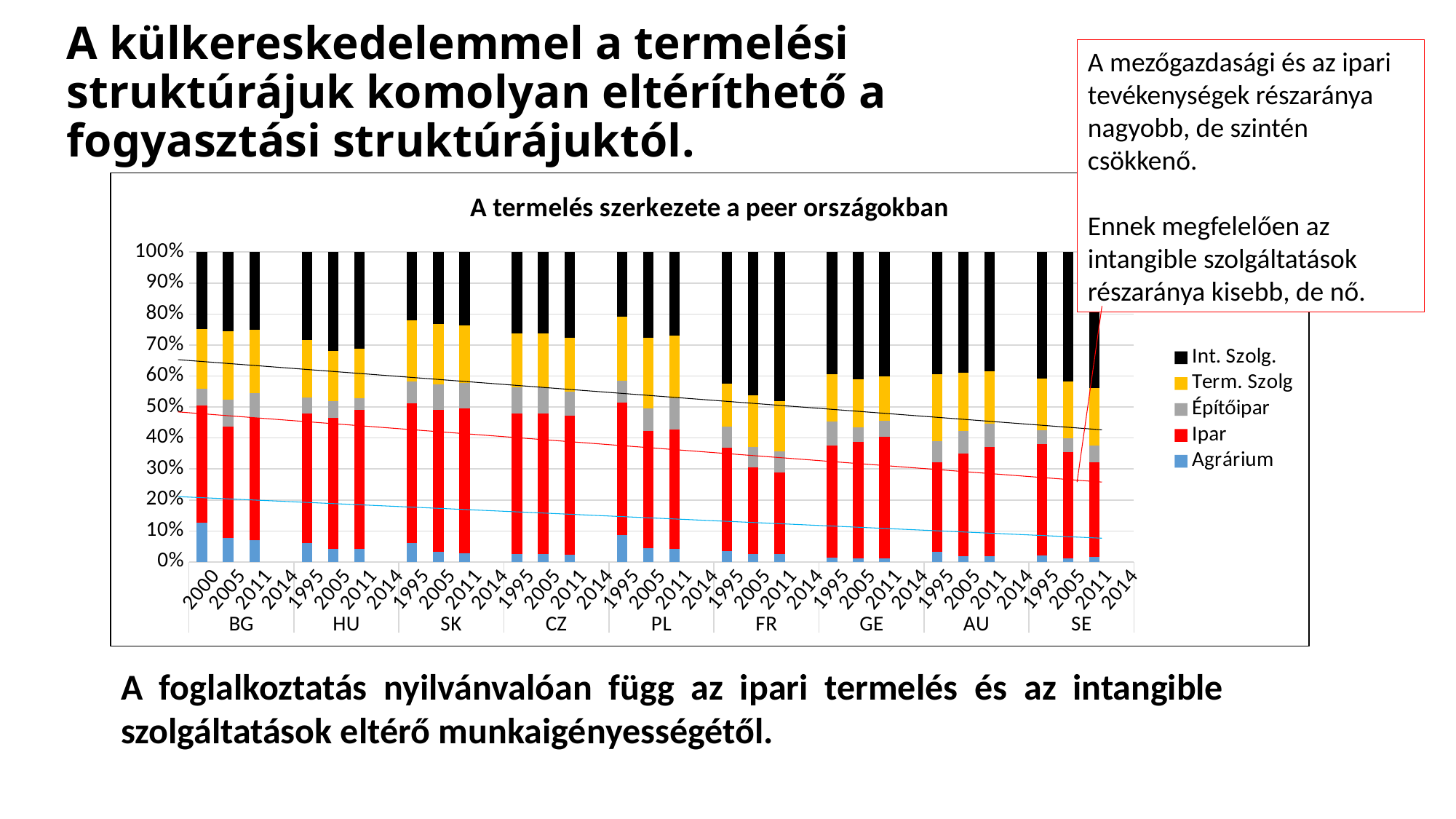
Is the Agrárium share for PL in 1995 greater or less than 10%? less Is the Agrárium share for GE in 2005 greater or less than 10%? less Does the Ipar share for FR rise or fall from 1995 to 2011? fall What kind of chart is shown on the slide? stacked bar chart Which colour represents the Ipar series in the chart? red Is the Agrárium share for BG in 2000 greater or less than 10%? greater How many series does the chart legend list? 5 Which bar in the chart has the highest Agrárium share? BG 2000 Which bar has the larger Agrárium share: BG 2000 or HU 1995? BG 2000 Which bar has the larger Ipar share: SK 1995 or FR 2011? SK 1995 What is the title of the chart? A termelés szerkezete a peer országokban How many country groups are shown on the x axis of the chart? 9